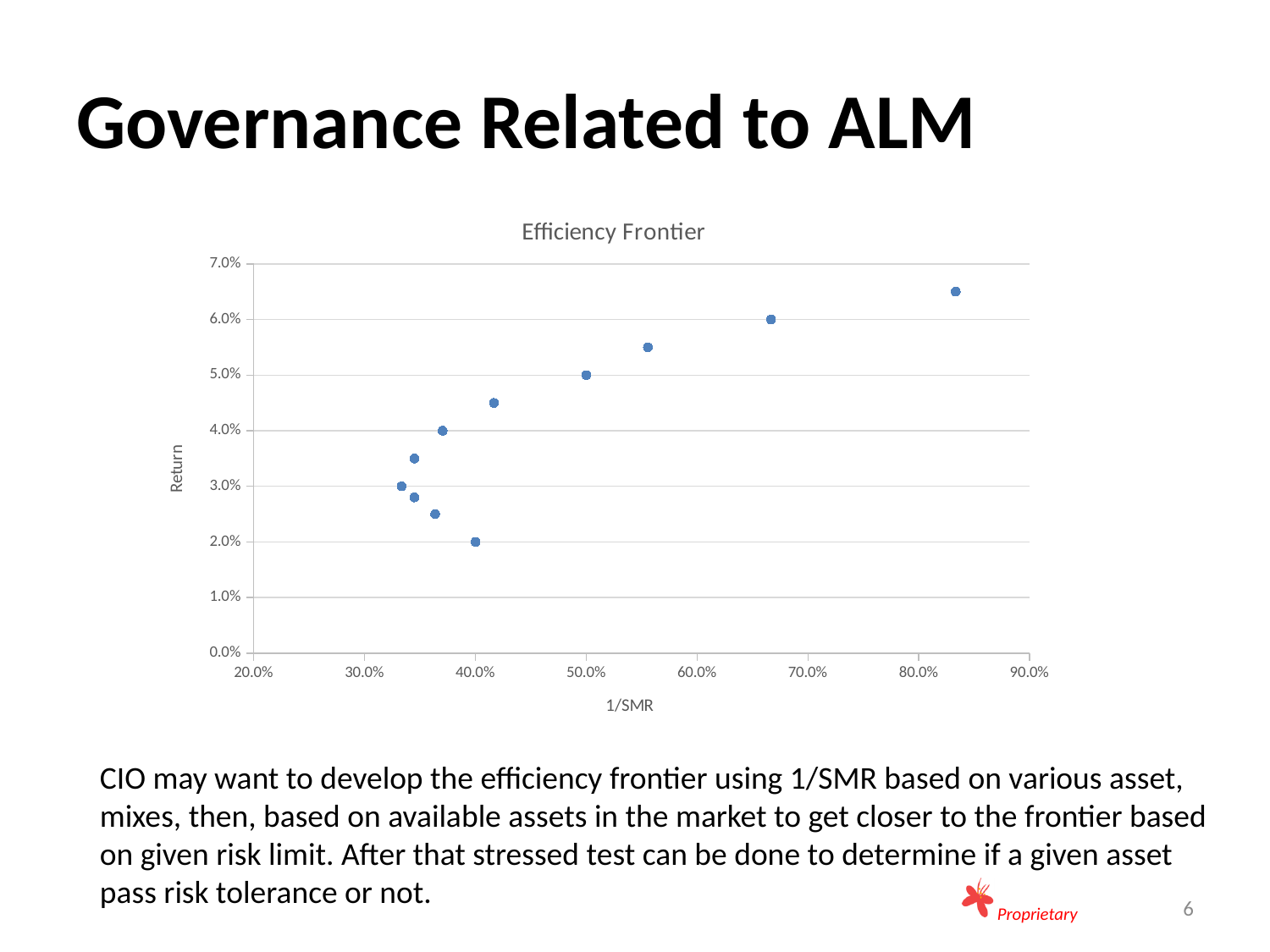
Is the 1/SMR value of the point with the lowest Return greater or less than 30.0%? greater Is the Return of the rightmost point (highest 1/SMR) greater or less than 6.0%? greater Which has the higher Return: the point at 1/SMR of 50.0% or the point at 1/SMR of 40.0%? The point at 50.0% What is the label of the x axis of the chart? 1/SMR What kind of chart is shown on the slide? Scatter chart What is the title of the chart? Efficiency Frontier What is the Return of the point plotted at 1/SMR of 40.0%? 2.0% What is the Return of the point plotted at 1/SMR of 50.0%? 5.0% Is the Return of the lowest point on the chart greater or less than 3.0%? less How many data points are plotted in the chart? 11 Do the Return values generally rise or fall as 1/SMR increases along the x axis? Rise